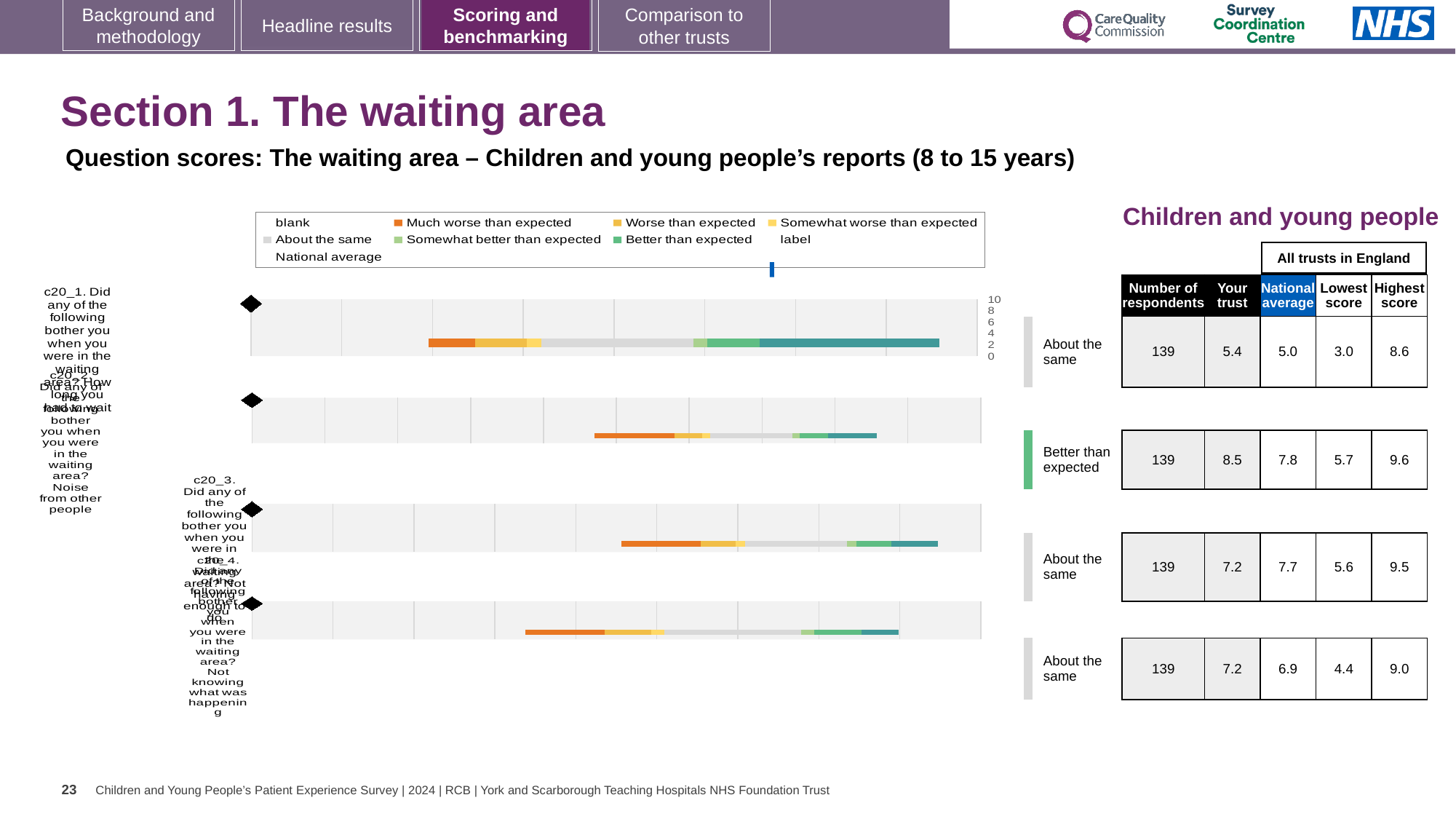
Which row has the higher 'Your trust' score: the first row (c20_1) or the row rated 'Better than expected'? Better than expected How many question rows (bars) are plotted in the chart area on this slide? 4 In the table, what is the lowest score in England for the first row (c20_1)? 3.0 In the table, what is the 'Your trust' score for the row rated 'Better than expected'? 8.5 What is the highest tick value shown on the chart's axis? 10 How many respondents are listed for each question in the table? 139 In the table, what is the highest score in England for the last row (c20_4)? 9.0 In the table, what is the national average for the row rated 'Better than expected'? 7.8 Which legend entry is shown in orange? Much worse than expected What kind of chart is used to show the question scores on this slide? bar chart In the table, what is the 'Your trust' score for the first row (c20_1)? 5.4 What is the difference between the 'Your trust' score and the national average for the row rated 'Better than expected'? 0.7